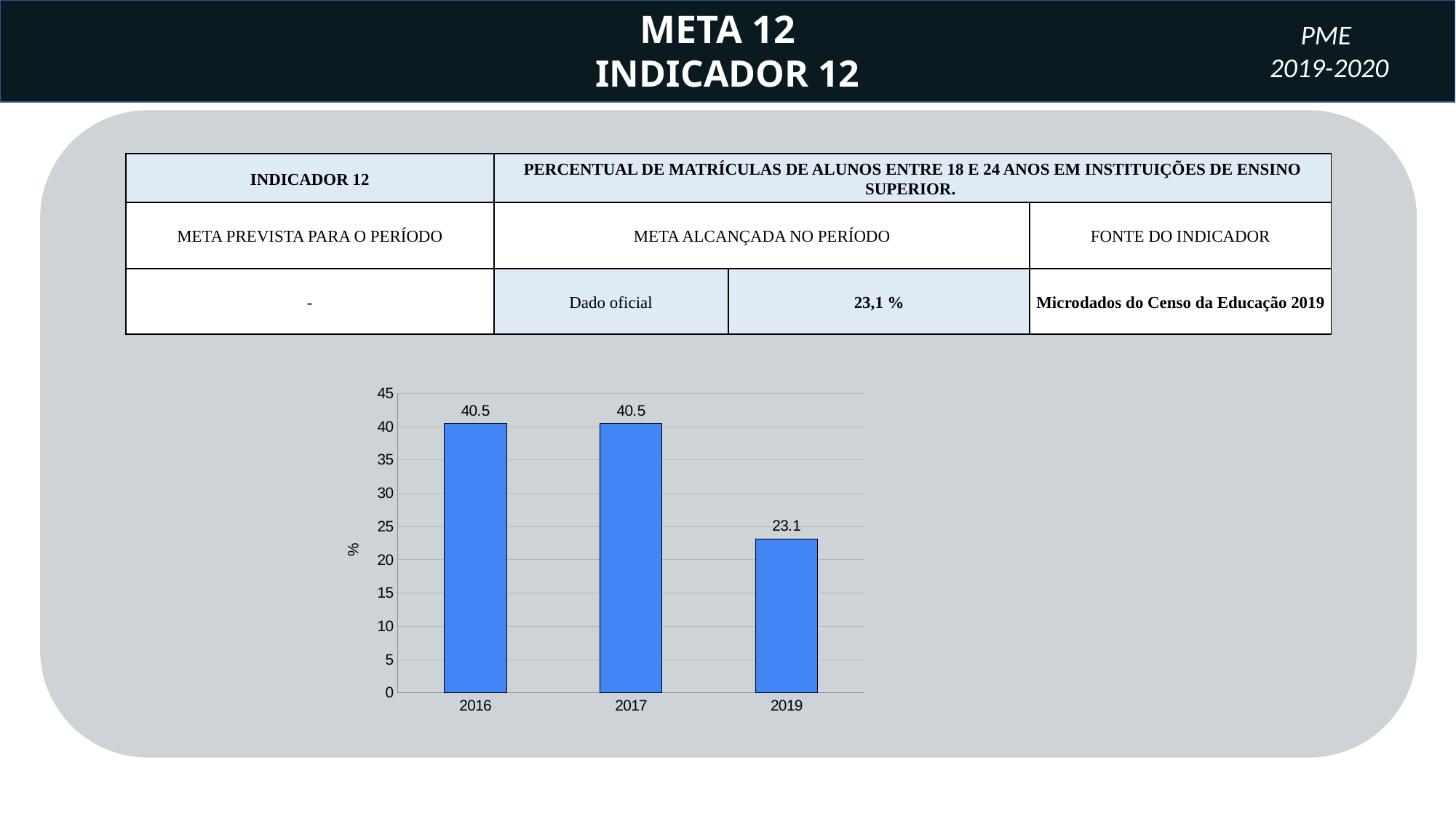
Is the value for 2019 greater or less than 25? less Which year has the lowest value? 2019 Do the values rise or fall from 2017 to 2019? fall What is the label on the vertical axis? % What is the difference between the values for 2017 and 2019? 17.4 What is the value for 2017? 40.5 What kind of chart is shown? bar chart Which is larger, the value for 2016 or the value for 2019? 2016 What is the value for 2019? 23.1 Is the value for 2016 greater or less than 35? greater How many years are shown on the x axis? 3 What is the value for 2016? 40.5